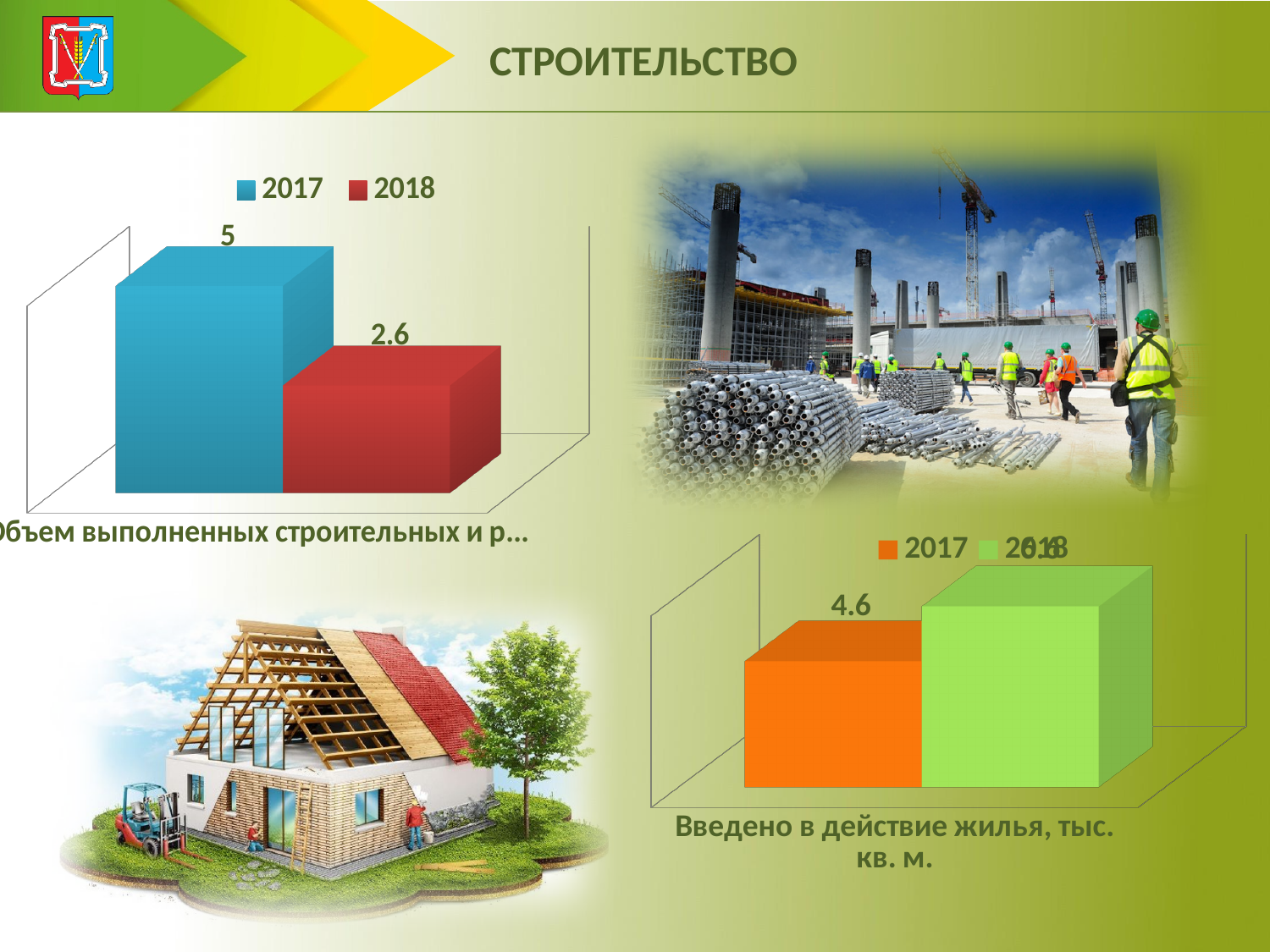
In the chart titled 'Введено в действие жилья, тыс. кв. м.', which year has the taller bar, 2017 or 2018? 2018 In the top-left chart, what colour is the 2018 bar? red In the top-left chart, what is the value for 2018? 2.6 In the chart titled 'Введено в действие жилья, тыс. кв. м.', how many series does the legend list? 2 What kind of chart is the top-left chart? bar chart In the top-left chart, what is the difference between the 2017 and 2018 values? 2.4 In the chart titled 'Введено в действие жилья, тыс. кв. м.', what colour is the 2017 bar? orange In the top-left chart, what is the value for 2017? 5 In the chart titled 'Введено в действие жилья, тыс. кв. м.', what is the value for 2017? 4.6 In the top-left chart, how many series does the legend list? 2 In the top-left chart, which year has the lower value? 2018 In the top-left chart, which year has the higher value? 2017